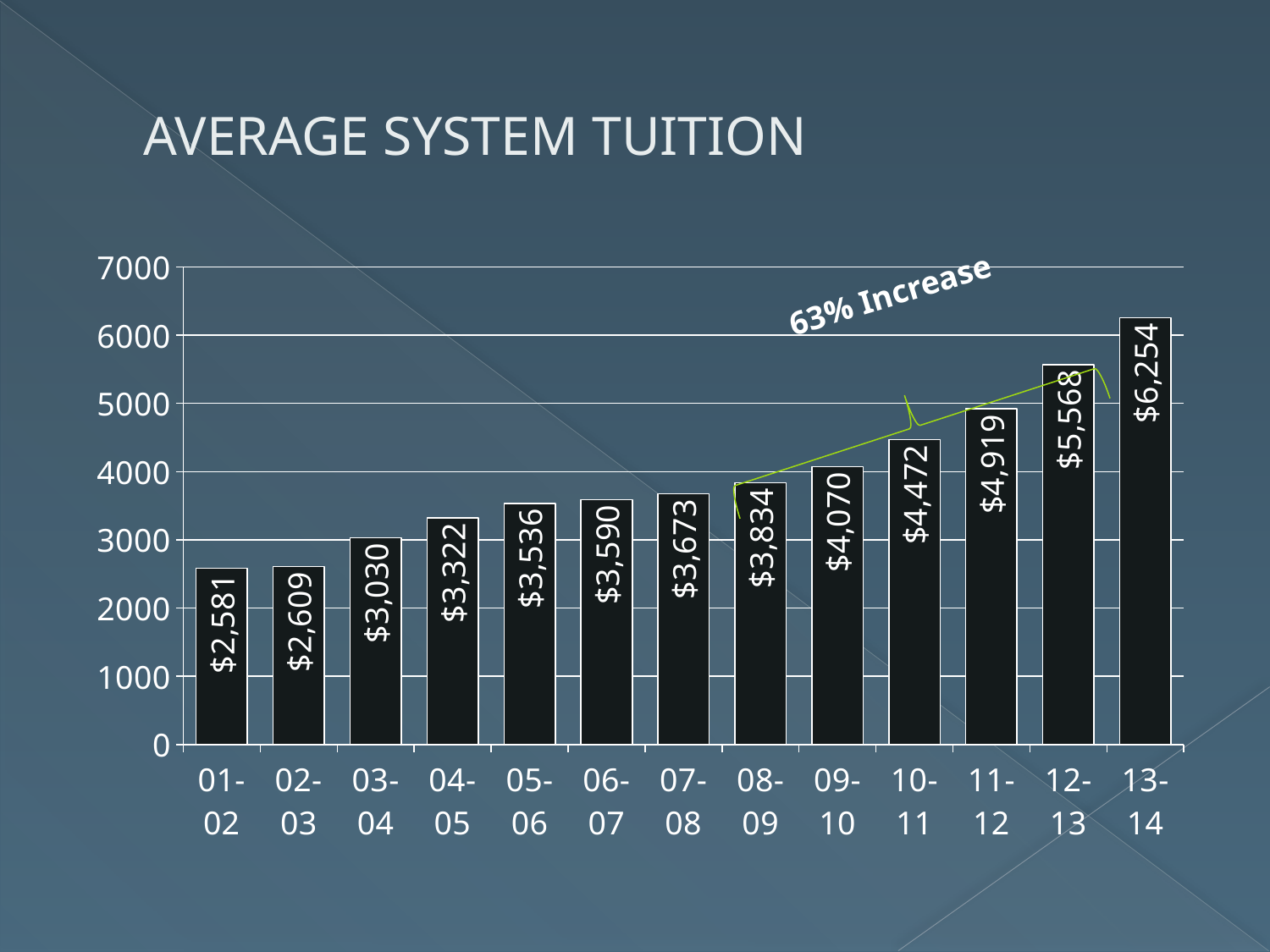
Which year has the lowest average system tuition? 01-02 How many academic years are shown on the chart? 13 What is the difference in tuition between 13-14 and 12-13? $686 What kind of chart is shown on the slide? bar chart What is the average system tuition for 08-09? $3,834 What is the average system tuition for 01-02? $2,581 Do tuition values rise or fall from 01-02 to 13-14? rise What is the average system tuition for 13-14? $6,254 Which year has the highest average system tuition? 13-14 Is the tuition for 11-12 greater or less than 5000? less Which is larger, the tuition for 10-11 or for 09-10? 10-11 What is the difference in tuition between 08-09 and 01-02? $1,253